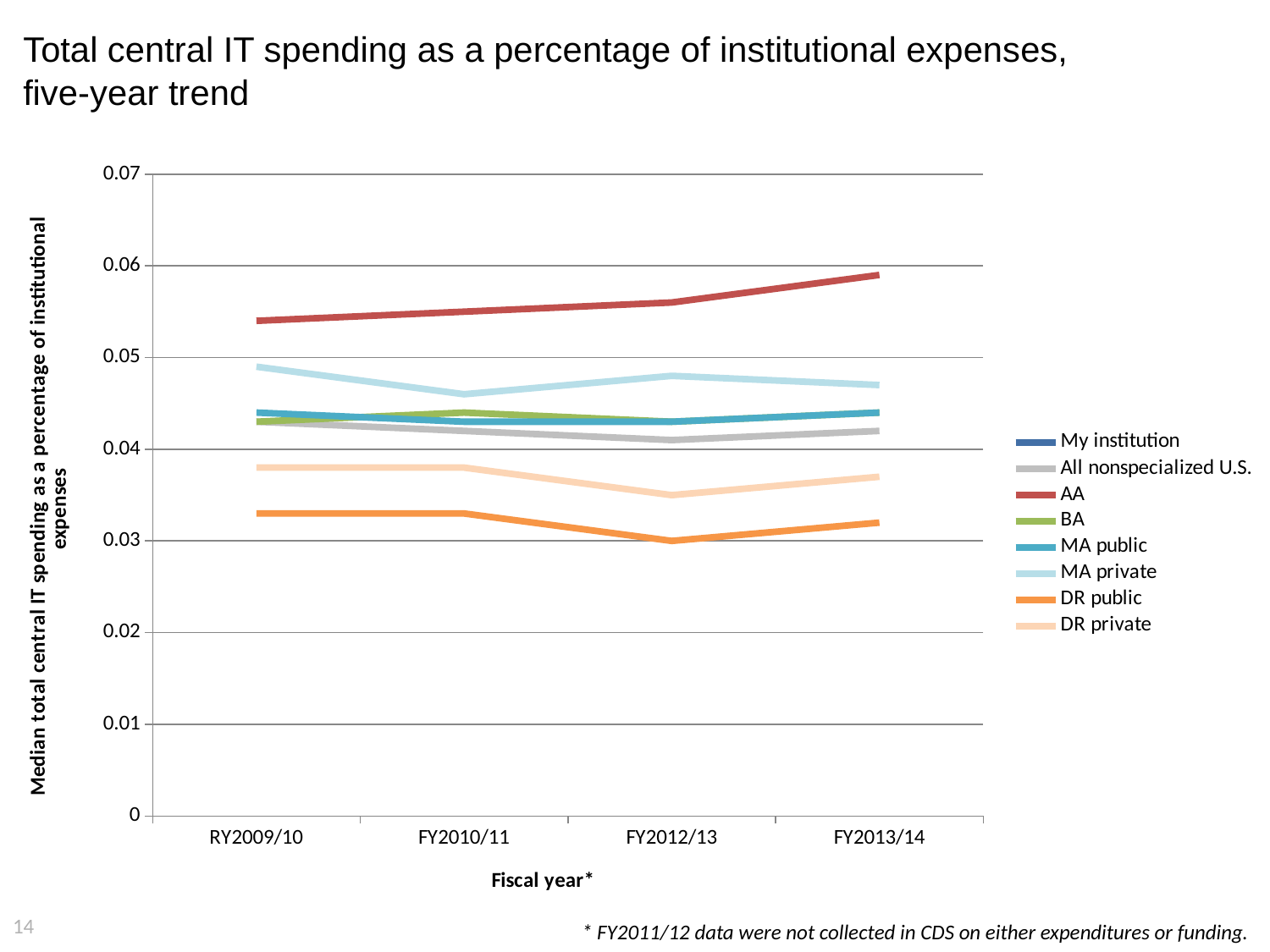
Is the value for DR private in FY2012/13 greater or less than 0.04? less Does the AA line rise or fall from RY2009/10 to FY2013/14? rise How many fiscal years are shown on the x axis? 4 Which is larger in FY2013/14, AA or DR public? AA Which is larger in FY2010/11, MA private or DR private? MA private Which series has the lowest values across all fiscal years? DR public Which series has the highest values across all fiscal years? AA What kind of chart is shown on the slide? line chart What is the title of the x axis? Fiscal year* Is the value for AA in RY2009/10 greater or less than 0.05? greater Is the value for AA in FY2013/14 greater or less than 0.05? greater How many series does the legend list? 8